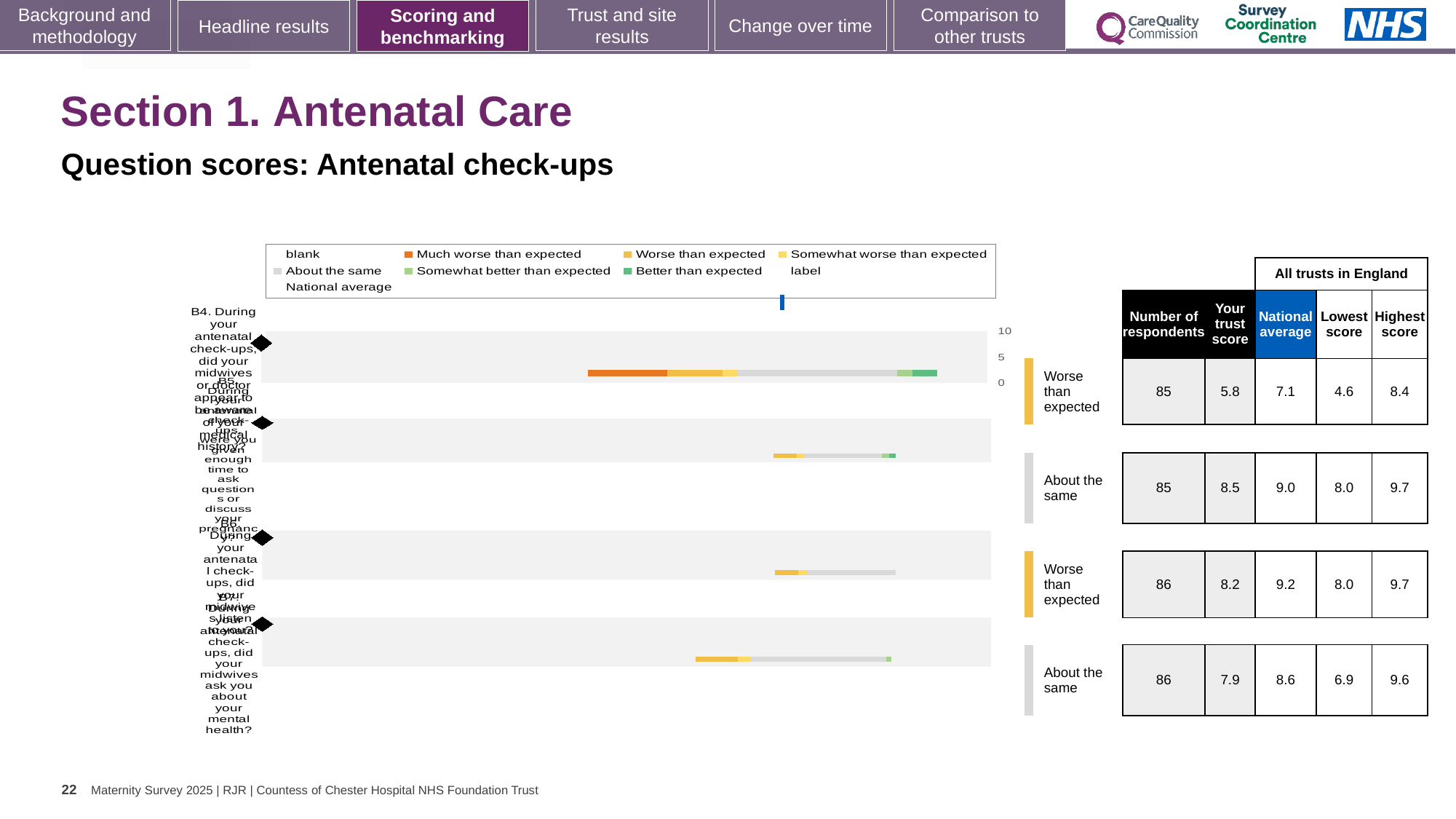
What benchmark label is shown for the second question? About the same In the table, what is the trust score for the first question, B4? 5.8 In the table, which is larger for the second question: the trust score or the national average? national average Which colour does the legend use for 'Much worse than expected'? orange What kind of chart is shown on the slide? bar chart What benchmark label is shown for the first (top) question, B4? Worse than expected In the table, what is the number of respondents for the third question? 86 How many question bars are plotted in the chart? 4 What benchmark label is shown for the fourth (bottom) question? About the same In the table, what is the difference between the national average and the trust score for the first question, B4? 1.3 In the table, what is the national average for the first question, B4? 7.1 What is the maximum value shown on the chart's axis? 10